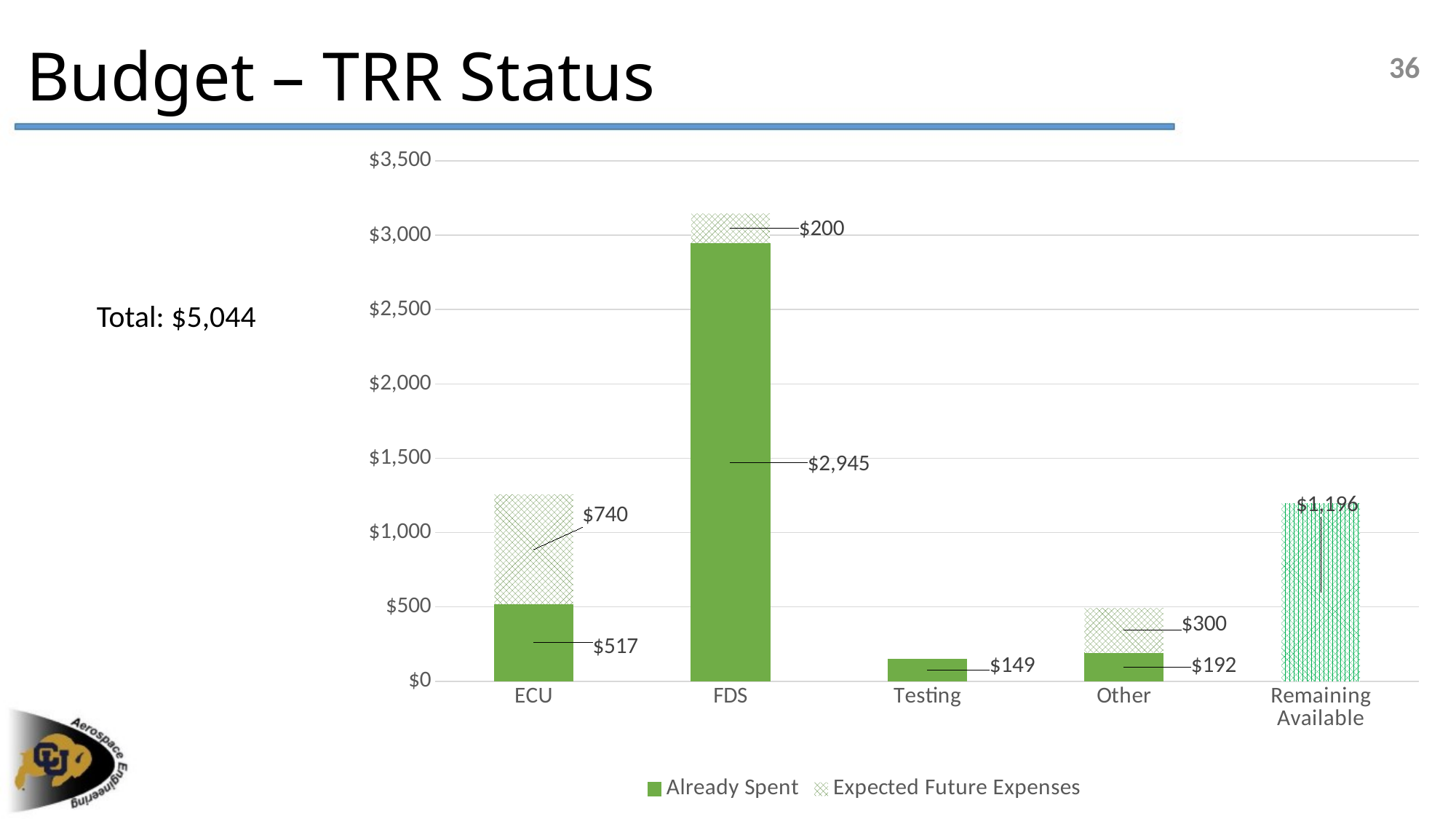
What is the difference between the Already Spent values for ECU and Other? $325 What is the Expected Future Expenses value for Other? $300 Which category has the lowest Already Spent value? Testing What is the total of the stacked bar for ECU? $1,257 What kind of chart is shown on the slide? Stacked bar chart How many series does the legend list? 2 Which category has the highest Already Spent value? FDS What is the Expected Future Expenses value for ECU? $740 What value is labelled on the Remaining Available bar? $1,196 What is the total of the stacked bar for FDS? $3,145 What is the Already Spent value for FDS? $2,945 What is the Already Spent value for Testing? $149